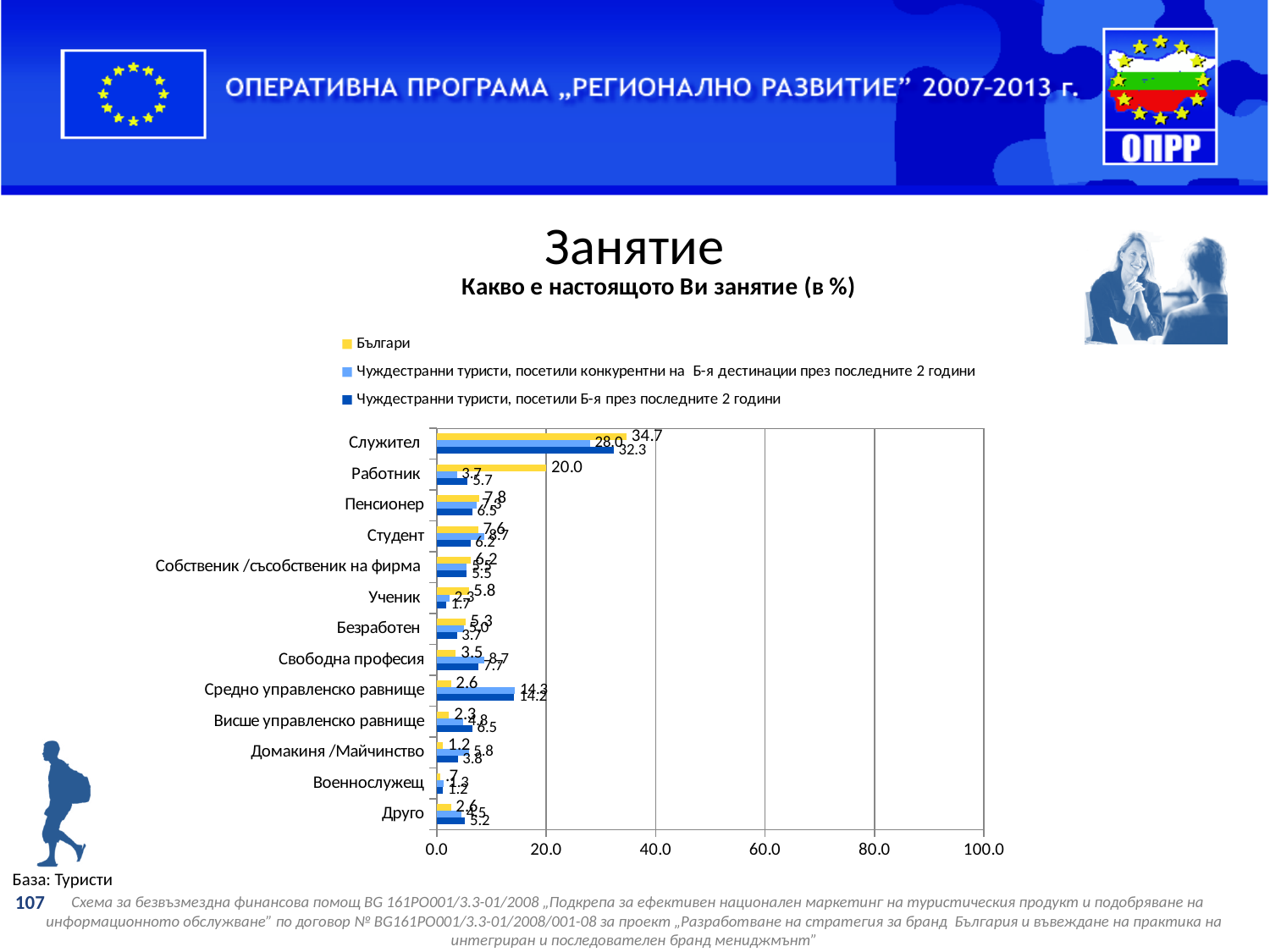
How many series does the legend list? 3 What is the value for Българи in the Работник category? 20.0 What is the value for Чуждестранни туристи, посетили Б-я през последните 2 години in the Служител category? 32.3 In the Средно управленско равнище category, which is larger: the value for Българи or the value for Чуждестранни туристи, посетили конкурентни на Б-я дестинации през последните 2 години? Чуждестранни туристи, посетили конкурентни на Б-я дестинации през последните 2 години What type of chart is shown on the slide? bar chart What is the value for Българи in the Служител category? 34.7 How many occupation categories are shown on the chart? 13 What is the difference between the Българи value and the Чуждестранни туристи, посетили конкурентни на Б-я дестинации value in the Служител category? 6.7 Which category has the lowest value for Българи? Военнослужещ Which category has the highest value for Българи? Служител What is the value for Българи in the Средно управленско равнище category? 2.6 Is the value for Българи in the Служител category greater or less than 20.0? greater